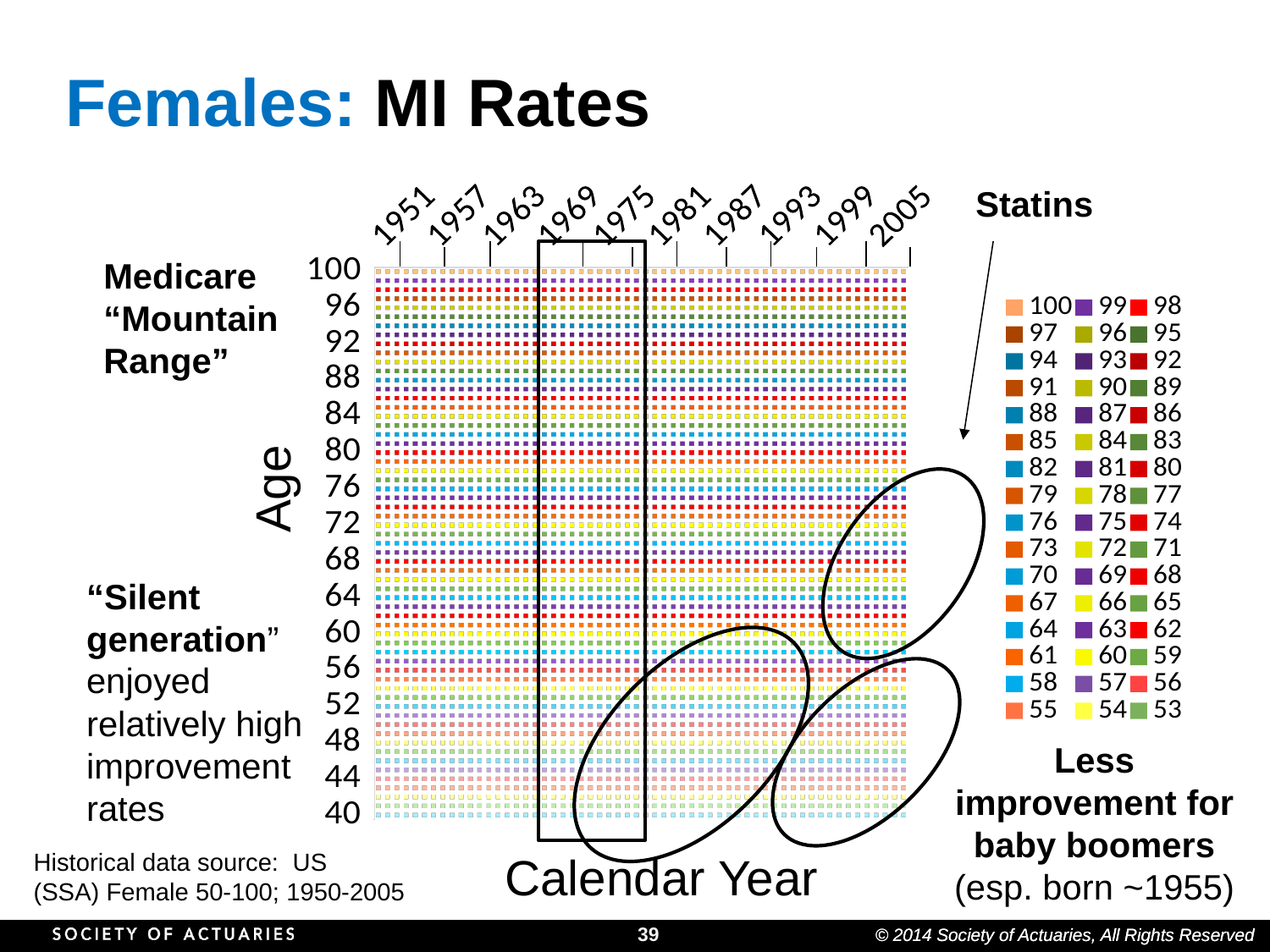
What is the highest age shown on the vertical axis of the chart? 100 How many series (ages) does the chart's legend list? 48 What is the first year label on the horizontal axis of the chart? 1951 What is the title of the chart on the slide? Females: MI Rates How many year tick labels are shown along the horizontal axis of the chart? 10 What is the label of the horizontal axis of the chart? Calendar Year What is the last year label on the horizontal axis of the chart? 2005 What is the lowest age listed in the chart's legend? 53 What kind of chart is shown on the slide? Scatter (dot) chart What is the lowest age shown on the vertical axis of the chart? 40 What is the highest age listed in the chart's legend? 100